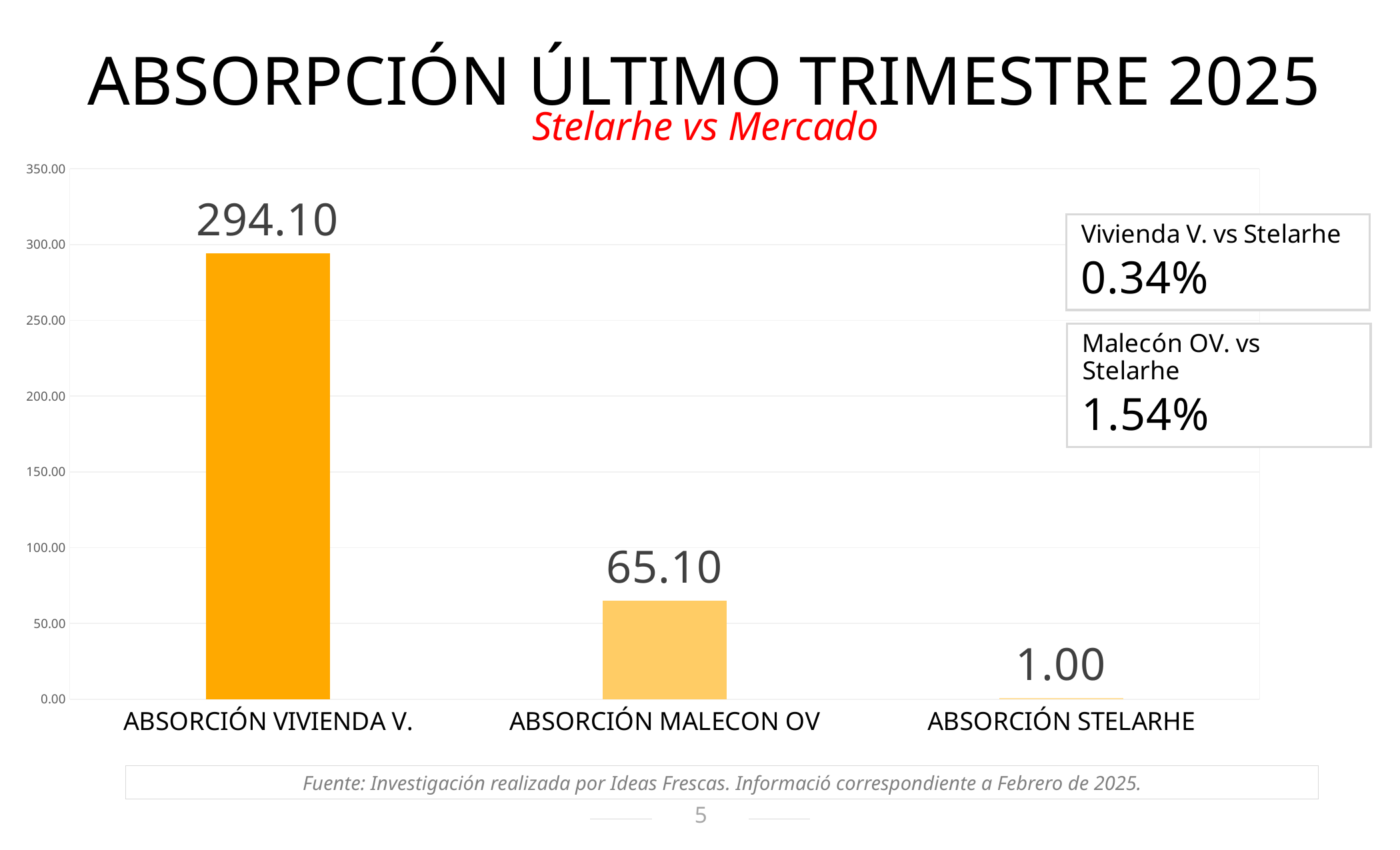
What is the difference between the values for ABSORCIÓN VIVIENDA V. and ABSORCIÓN MALECON OV? 229.00 Which category has the highest value? ABSORCIÓN VIVIENDA V. What is the value for ABSORCIÓN VIVIENDA V.? 294.10 What is the difference between the values for ABSORCIÓN MALECON OV and ABSORCIÓN STELARHE? 64.10 What kind of chart is shown on the slide? bar chart How many categories are shown in the chart? 3 Is the value for ABSORCIÓN VIVIENDA V. greater or less than 250.00? greater What is the red subtitle shown under the slide title? Stelarhe vs Mercado Which is larger, the value for ABSORCIÓN MALECON OV or ABSORCIÓN STELARHE? ABSORCIÓN MALECON OV What is the value for ABSORCIÓN STELARHE? 1.00 Which category has the lowest value? ABSORCIÓN STELARHE What is the value for ABSORCIÓN MALECON OV? 65.10